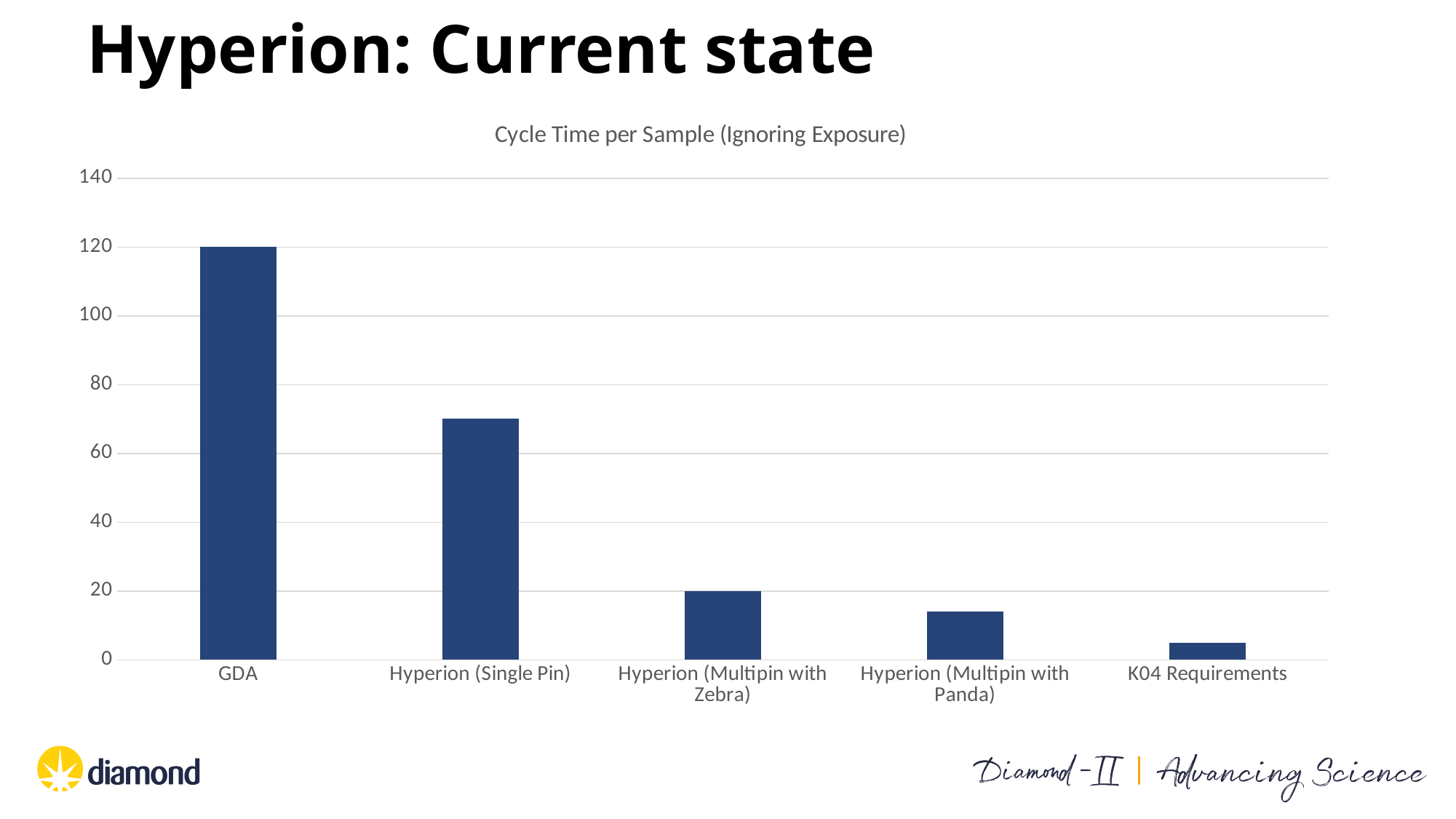
What kind of chart is shown on the slide? bar chart What is the difference between the value for GDA and the value for Hyperion (Multipin with Zebra)? 100 Is the value for Hyperion (Single Pin) greater or less than 60? greater Is the value for K04 Requirements greater or less than 20? less Which category has the lowest cycle time per sample? K04 Requirements Which is larger, the value for Hyperion (Single Pin) or the value for Hyperion (Multipin with Panda)? Hyperion (Single Pin) How many categories are shown on the x axis? 5 What is the value for GDA? 120 What is the value for Hyperion (Multipin with Zebra)? 20 Do the values rise or fall from left to right along the x axis? fall Which category has the highest cycle time per sample? GDA Is the value for Hyperion (Multipin with Panda) greater or less than 20? less